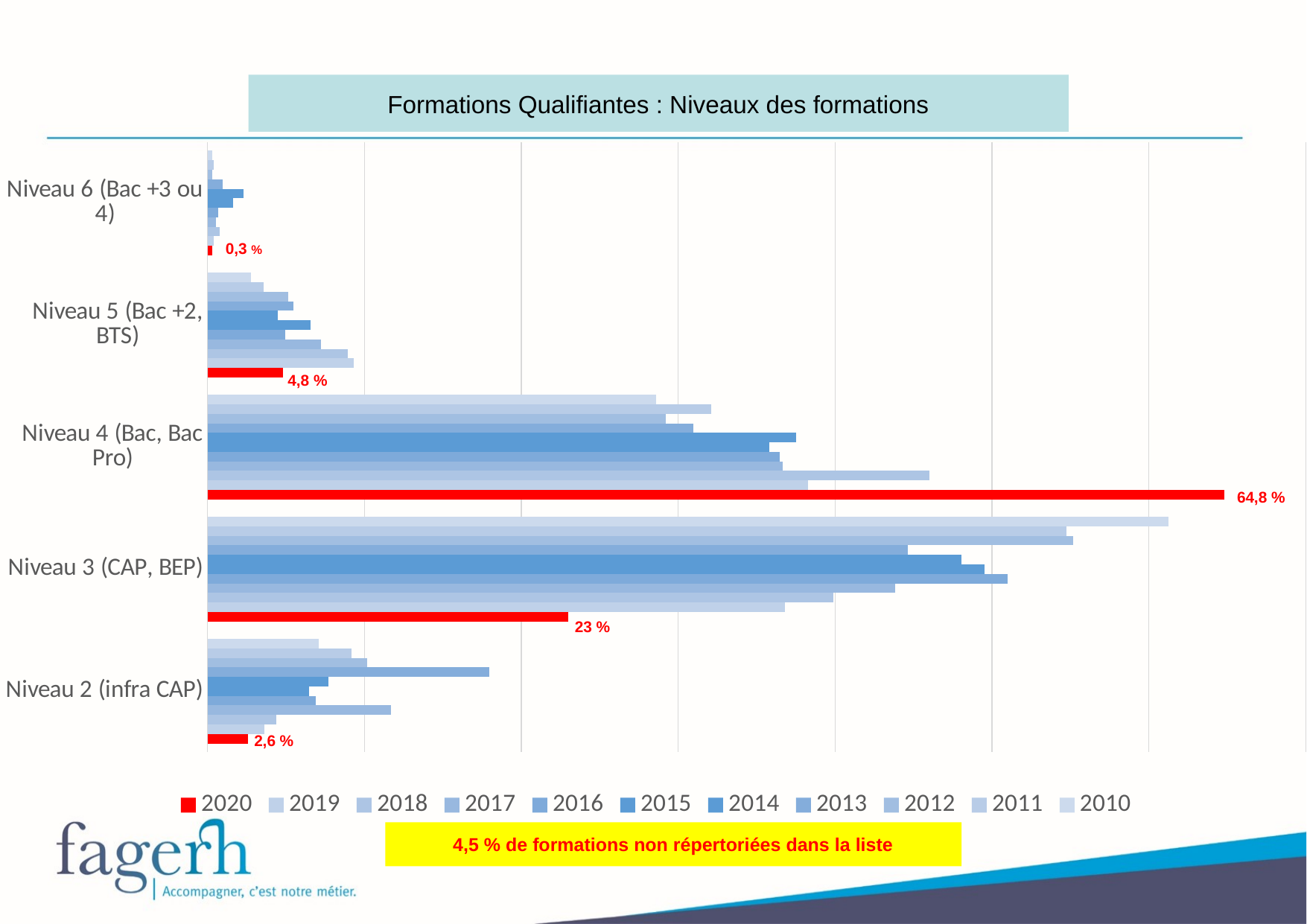
What is the 2020 value for Niveau 6 (Bac +3 ou 4)? 0,3 % Which has the larger 2020 value, Niveau 5 (Bac +2, BTS) or Niveau 2 (infra CAP)? Niveau 5 (Bac +2, BTS) What is the 2020 value for Niveau 4 (Bac, Bac Pro)? 64,8 % What is the 2020 value for Niveau 2 (infra CAP)? 2,6 % What is the 2020 value for Niveau 5 (Bac +2, BTS)? 4,8 % What is the difference between the 2020 values for Niveau 4 (Bac, Bac Pro) and Niveau 3 (CAP, BEP)? 41,8 % Which level has the lowest 2020 value? Niveau 6 (Bac +3 ou 4) What is the 2020 value for Niveau 3 (CAP, BEP)? 23 % How many levels (categories) are shown on the chart? 5 What type of chart is shown on the slide? Bar chart Which level has the highest 2020 value? Niveau 4 (Bac, Bac Pro) How many series does the legend list? 11